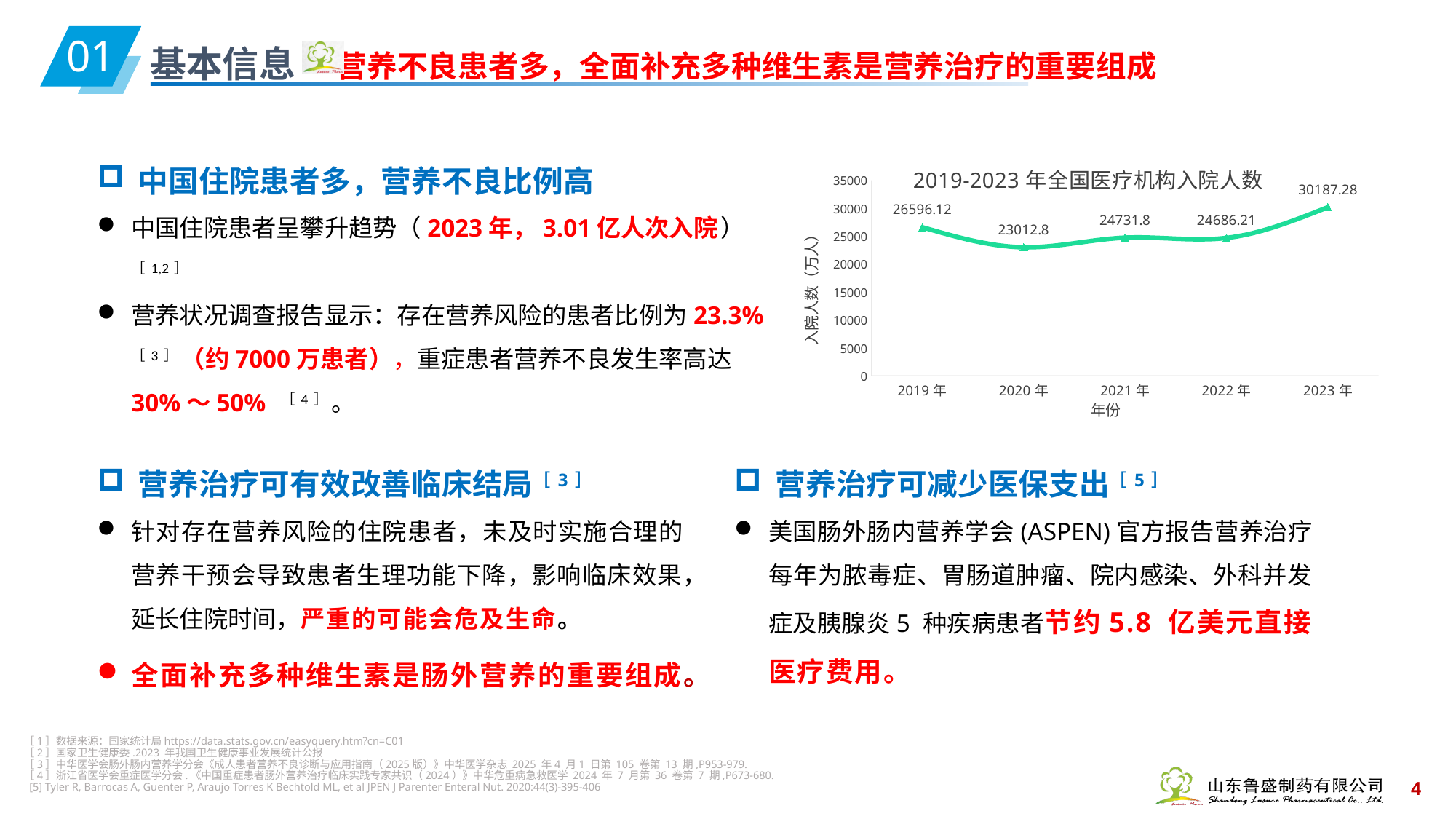
What type of chart is shown on the slide? line chart Which is larger, the value for 2019 年 or the value for 2020 年? 2019 年 What is the value for 2019 年 in the chart? 26596.12 What is the value for 2020 年 in the chart? 23012.8 What is the label of the y axis in the chart? 入院人数（万人） Which year has the lowest admission count in the chart? 2020 年 What is the value for 2023 年 in the chart? 30187.28 What is the title of the chart on the slide? 2019-2023 年全国医疗机构入院人数 Which year has the highest admission count in the chart? 2023 年 What is the difference between the values for 2023 年 and 2019 年? 3591.16 What is the difference between the values for 2021 年 and 2020 年? 1719 How many years (data points) are plotted in the chart? 5